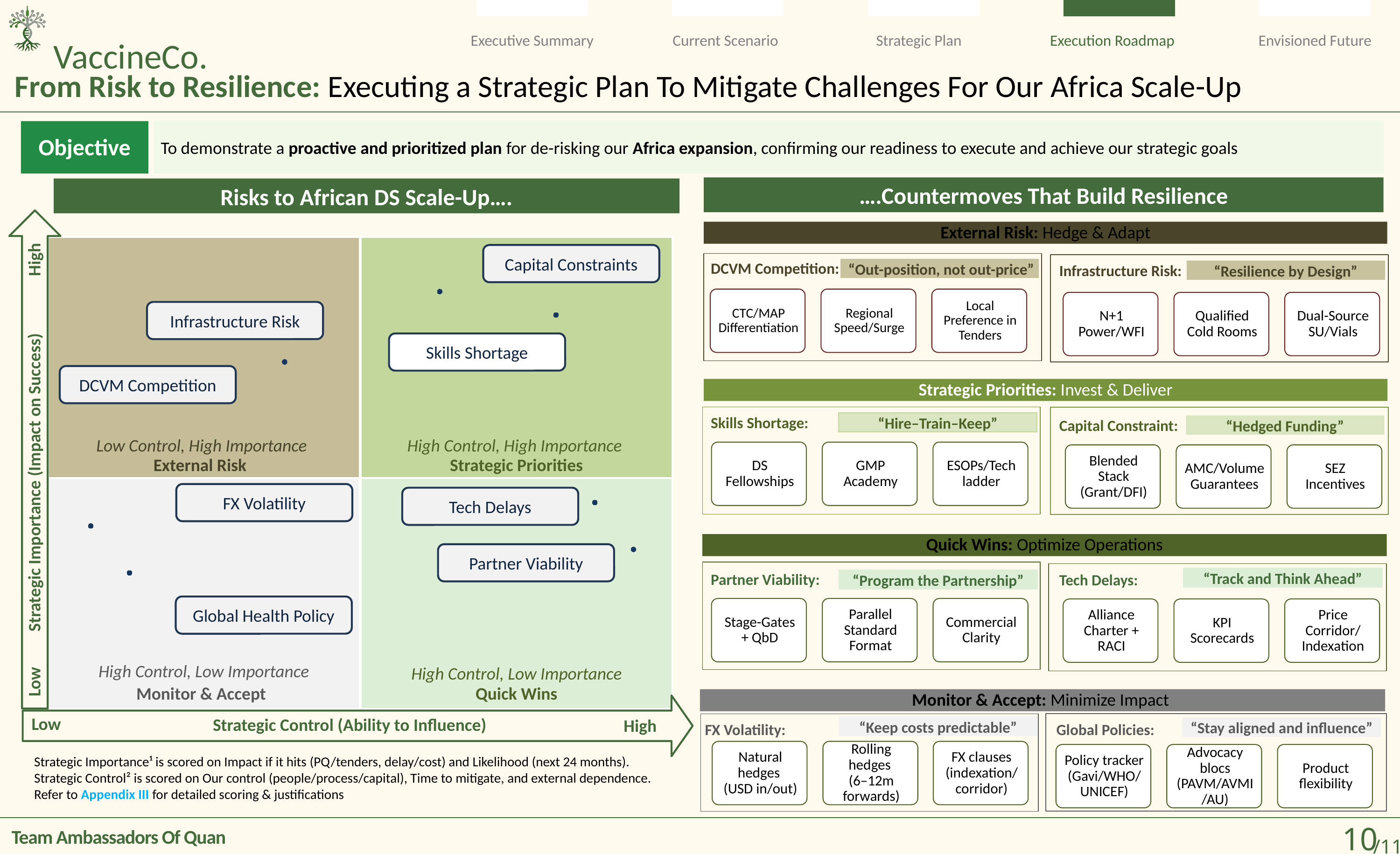
Which risk is plotted with the highest strategic control on the risk matrix? Partner Viability Which two risks are plotted in the Quick Wins quadrant of the risk matrix? Tech Delays and Partner Viability What kind of chart is shown under "Risks to African DS Scale-Up...."? A 2x2 matrix (scatter plot) of risks What is the label of the horizontal axis on the risk matrix? Strategic Control (Ability to Influence) In which quadrant of the risk matrix does DCVM Competition appear? External Risk (Low Control, High Importance) Which risk is plotted with the lowest strategic importance on the risk matrix? Global Health Policy Which risk is plotted with the lowest strategic control on the risk matrix? FX Volatility How many risks are plotted on the Risks to African DS Scale-Up matrix? 8 In which quadrant of the risk matrix does Skills Shortage appear? Strategic Priorities (High Control, High Importance) Which risk is plotted with higher strategic importance on the risk matrix, Skills Shortage or Infrastructure Risk? Skills Shortage Which risk is plotted with the highest strategic importance on the risk matrix? Capital Constraints What is the label of the vertical axis on the risk matrix? Strategic Importance (Impact on Success)